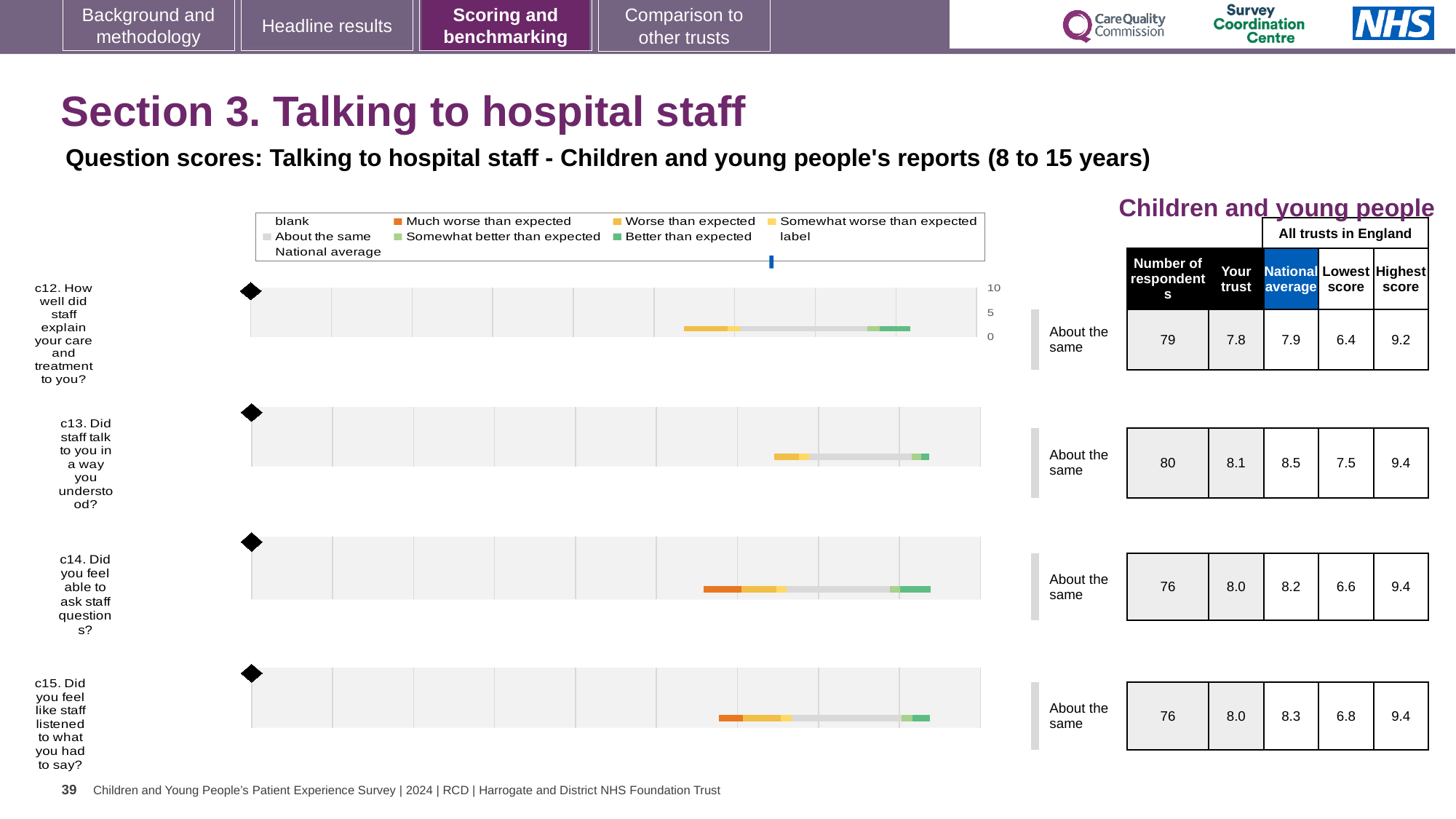
Which question has the highest 'Your trust' score? c13 For c12 (How well did staff explain your care and treatment to you?), what is the 'Your trust' score? 7.8 How many survey questions (c12 to c15) are charted on this slide? 4 For c12, what is the highest score among all trusts in England? 9.2 For c13 (Did staff talk to you in a way you understood?), what is the national average score? 8.5 What kind of chart is used to show the question scores on this slide? bar chart For c12, which is larger: the 'Your trust' score or the national average? National average What is the maximum value shown on the score axis of the charts? 10 What benchmark category is shown for c15 (Did you feel like staff listened to what you had to say?)? About the same For c13, what is the difference between the national average and the 'Your trust' score? 0.4 How many respondents answered c14 (Did you feel able to ask staff questions?)? 76 Which question has the lowest 'Lowest score' among all trusts in England? c12